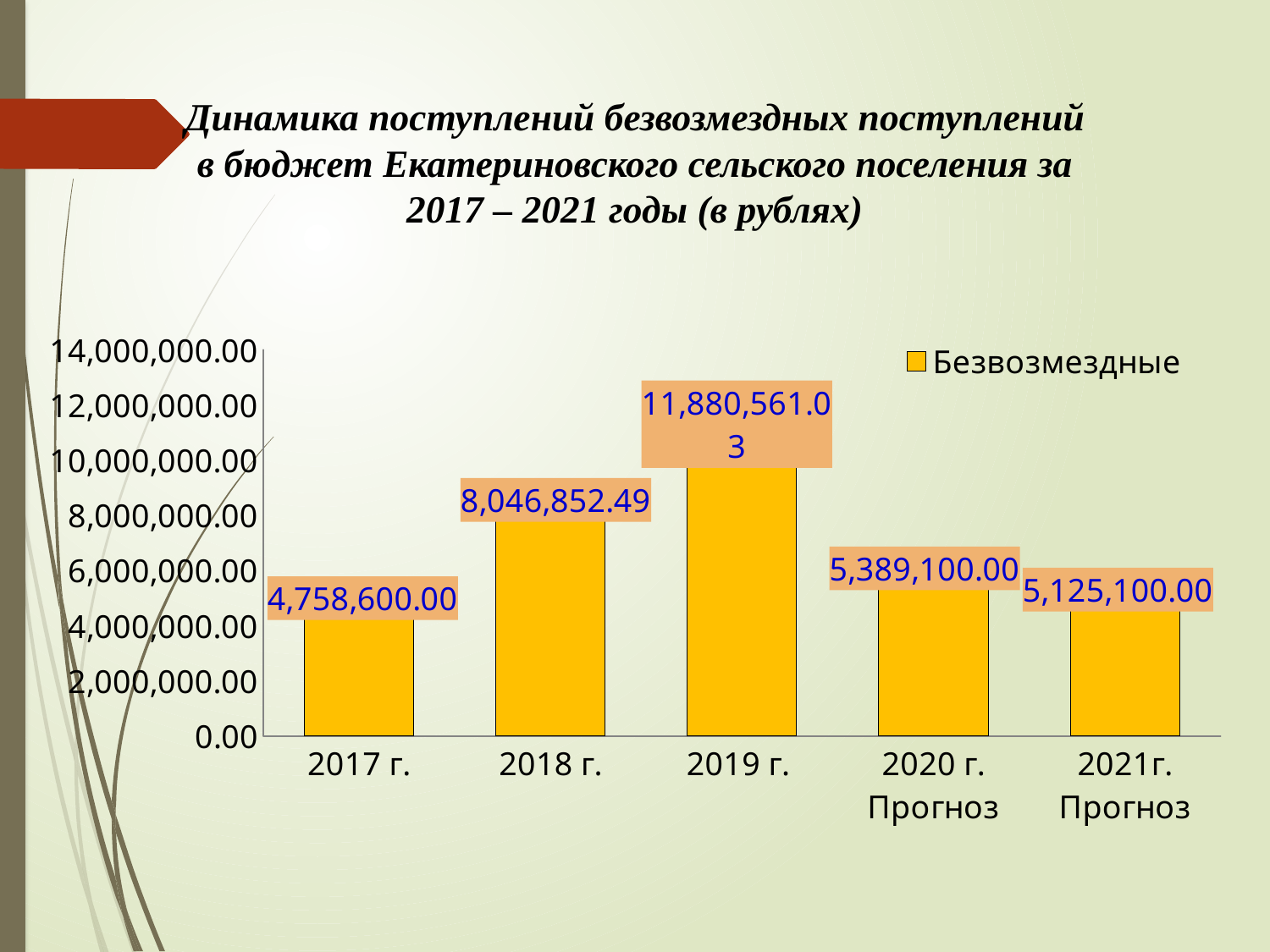
How many categories are shown on the x axis? 5 What is the value for 2017 г.? 4,758,600.00 What kind of chart is shown on the slide? bar chart What is the value for 2019 г.? 11,880,561.03 Which year has the lowest value? 2017 г. Which year has the highest value? 2019 г. What series name is listed in the legend? Безвозмездные What is the difference between the values for 2020 г. Прогноз and 2021г. Прогноз? 264,000.00 Which is larger, the value for 2018 г. or the value for 2020 г. Прогноз? 2018 г. Is the value for 2019 г. greater or less than 10,000,000.00? greater What is the difference between the values for 2019 г. and 2018 г.? 3,833,708.54 What is the value for 2021г. Прогноз? 5,125,100.00